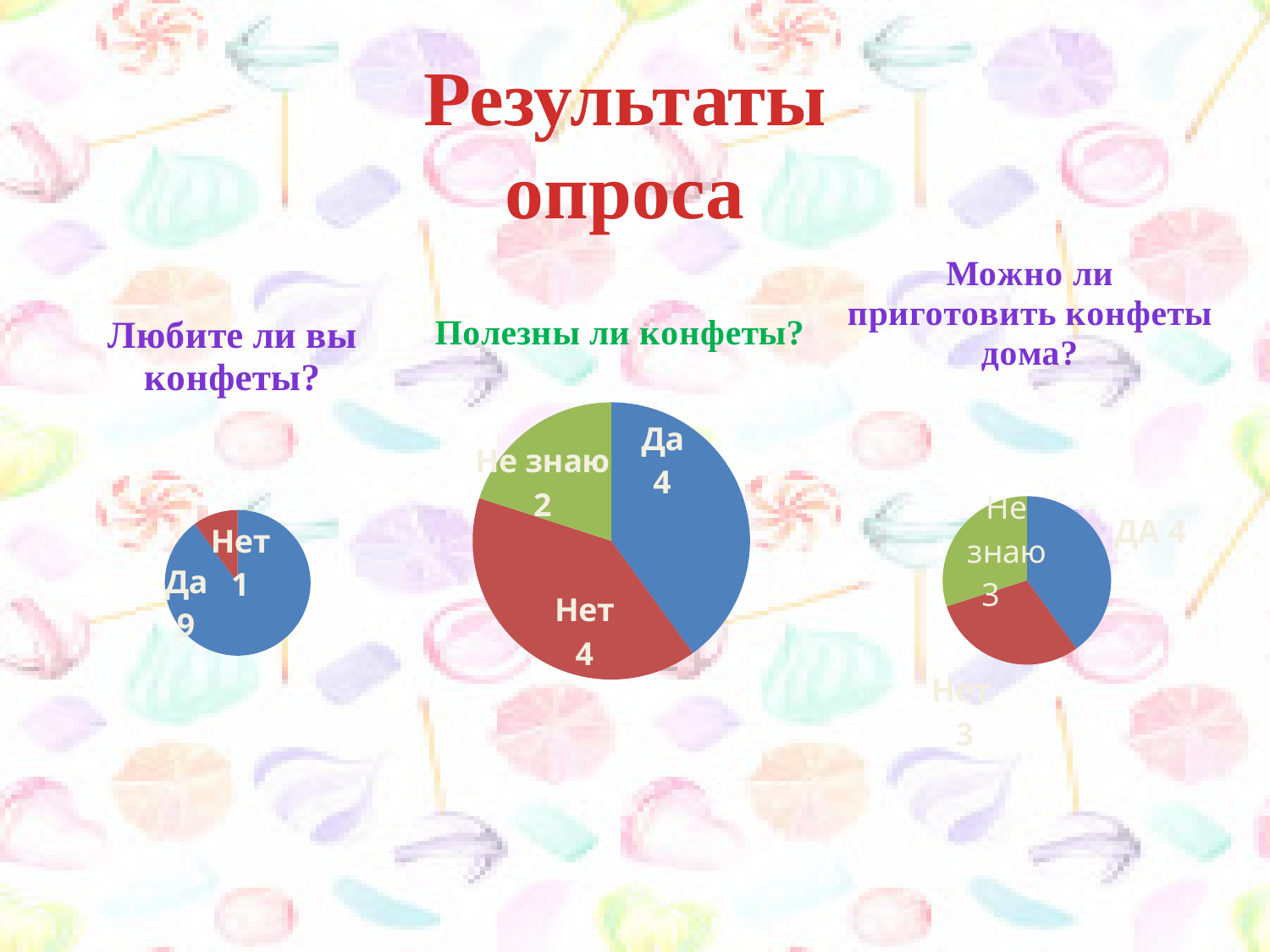
In the chart "Полезны ли конфеты?", which is larger, Да or Не знаю? Да In the chart "Любите ли вы конфеты?", what share of the pie does Да represent? 90% In the chart "Полезны ли конфеты?", which category has the smallest value? Не знаю In the chart "Полезны ли конфеты?", what share of the pie does Не знаю represent? 20% How many pie charts are on the slide? 3 What type of chart is used for "Любите ли вы конфеты?"? Pie chart In the chart "Полезны ли конфеты?", what is the value for Не знаю? 2 In the chart "Любите ли вы конфеты?", what is the value for Да? 9 In the chart "Можно ли приготовить конфеты дома?", what is the value for Не знаю? 3 How many categories are shown in the chart "Полезны ли конфеты?"? 3 In the chart "Любите ли вы конфеты?", what is the value for Нет? 1 In the chart "Любите ли вы конфеты?", what is the difference between Да and Нет? 8